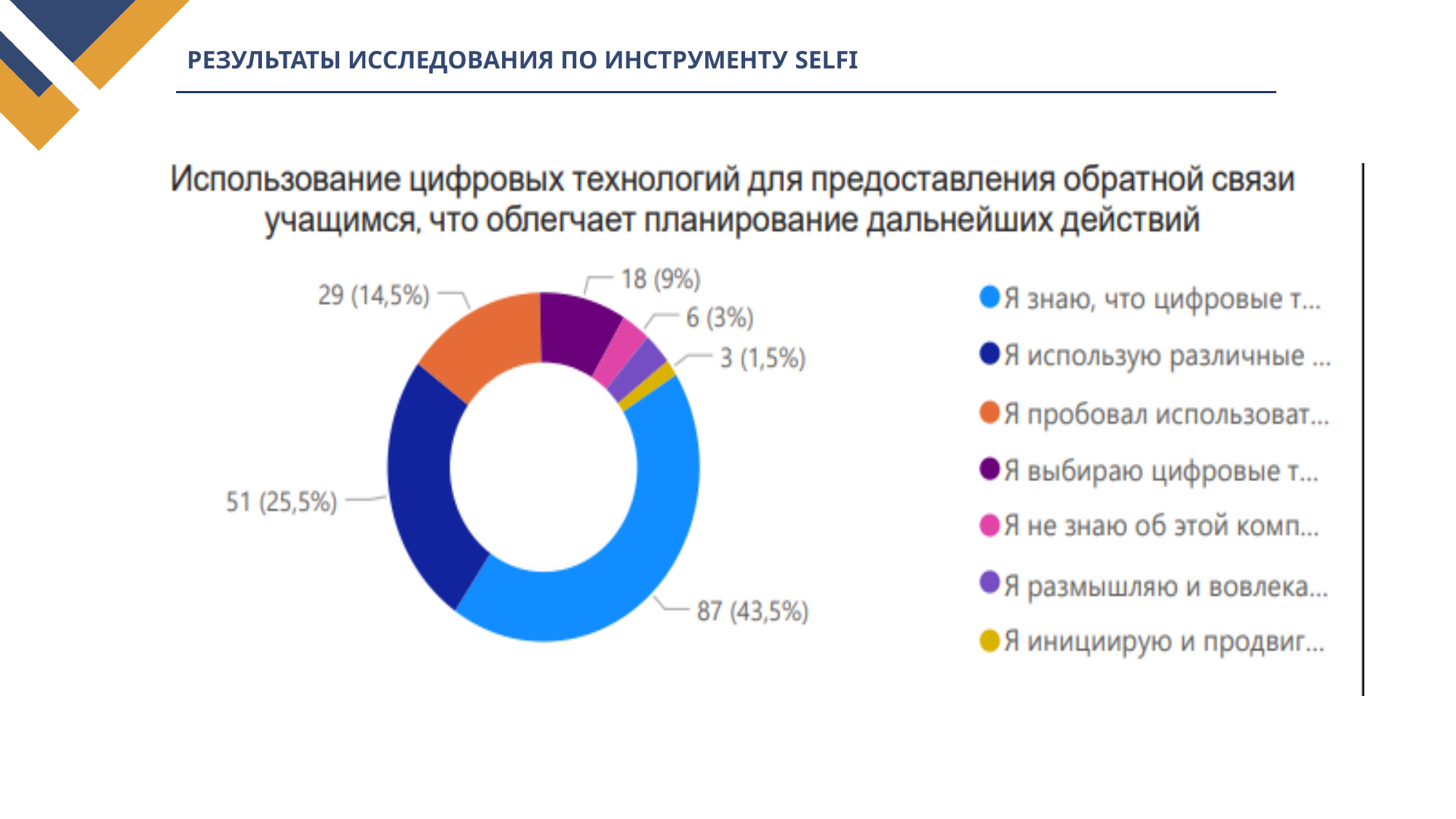
What value is shown for the light blue slice "Я знаю, что цифровые т..."? 87 (43,5%) Which legend category has the largest slice of the chart? Я знаю, что цифровые т... (light blue) What value is shown for the dark purple slice "Я выбираю цифровые т..."? 18 (9%) What value is shown for the dark blue slice "Я использую различные ..."? 51 (25,5%) Which slice is larger: the orange "Я пробовал использоват..." or the dark purple "Я выбираю цифровые т..."? orange "Я пробовал использоват..." How many entries does the legend of the chart list? 7 What is the difference in count between the light blue slice (87) and the dark blue slice (51)? 36 What kind of chart is shown on the slide? pie chart (donut) What is the title of the chart? Использование цифровых технологий для предоставления обратной связи учащимся, что облегчает планирование дальнейших действий What value is shown for the orange slice "Я пробовал использоват..."? 29 (14,5%) What value is shown for the pink slice "Я не знаю об этой комп..."? 6 (3%) What share of the chart does the light blue slice "Я знаю, что цифровые т..." represent? 43,5%